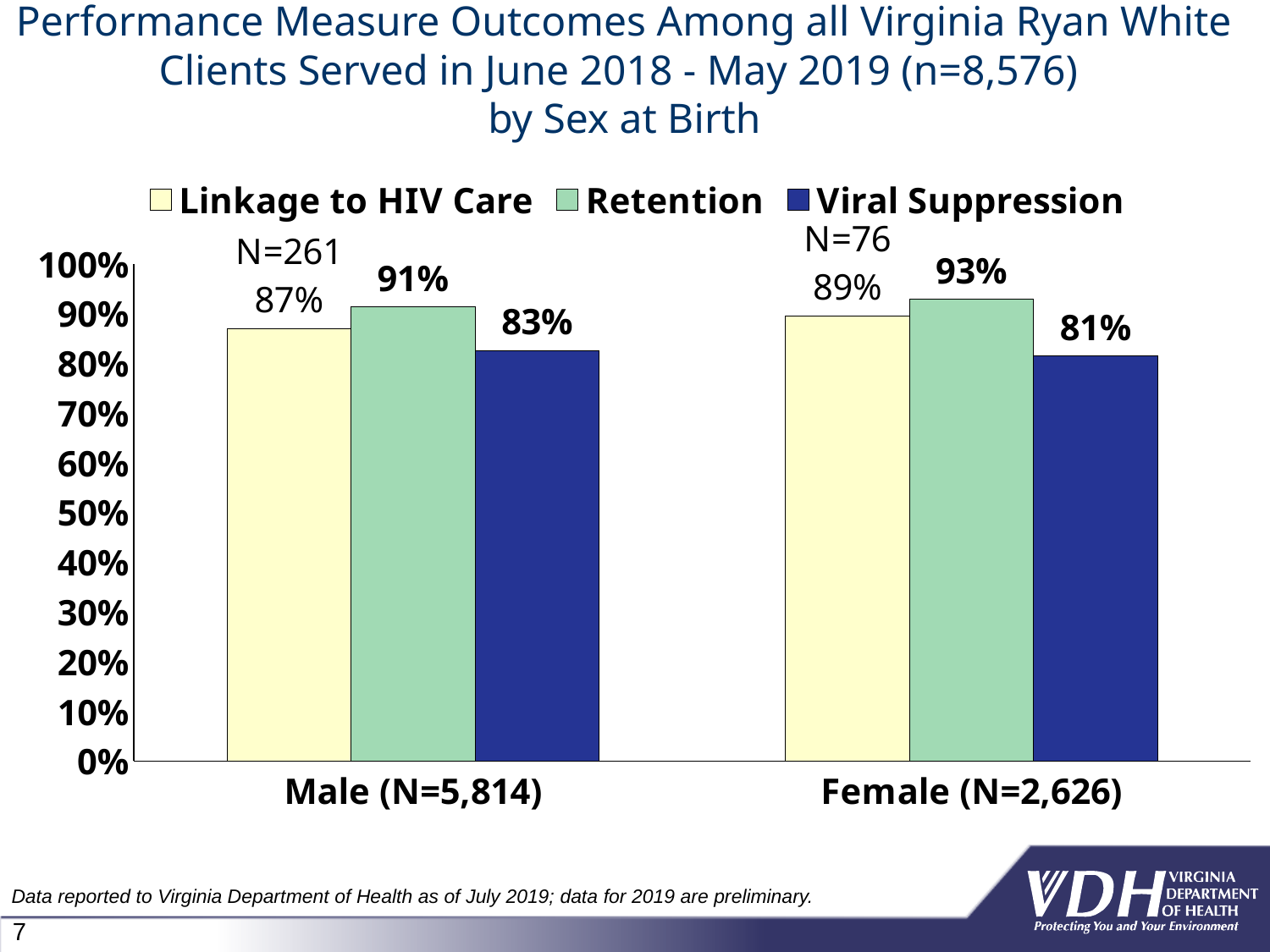
What is the Linkage to HIV Care value for Female (N=2,626)? 89% Which is larger: Viral Suppression for Male (N=5,814) or Viral Suppression for Female (N=2,626)? Male (N=5,814) What kind of chart is shown on the slide? Bar chart What is the Retention value for Male (N=5,814)? 91% Which series has the highest value for Female (N=2,626)? Retention What is the difference between Linkage to HIV Care and Viral Suppression for Male (N=5,814)? 4% How many categories are shown on the x axis? 2 How many series does the legend list? 3 What is the difference between the Retention values for Female (N=2,626) and Male (N=5,814)? 2% Which series has the lowest value for Male (N=5,814)? Viral Suppression What is the Viral Suppression value for Female (N=2,626)? 81% What is the N value printed above the Linkage to HIV Care bar for Male (N=5,814)? N=261